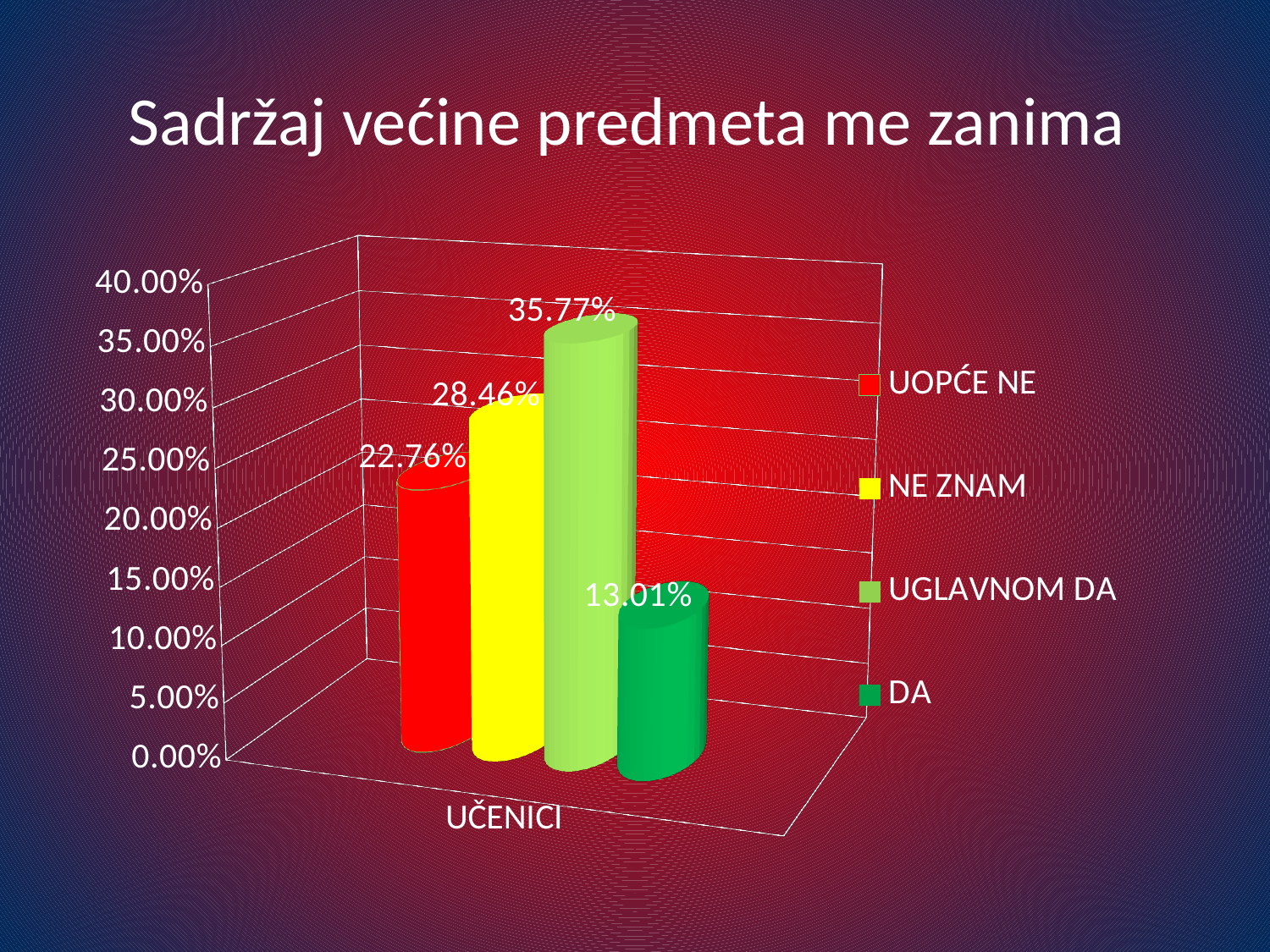
How many series does the legend list? 4 What is the value for UGLAVNOM DA? 35.77% Which series has the highest value? UGLAVNOM DA What is the title of the chart? Sadržaj većine predmeta me zanima What kind of chart is shown on the slide? Bar chart What is the value for DA? 13.01% What is the value for NE ZNAM? 28.46% What is the difference between the values for NE ZNAM and UOPĆE NE? 5.70% Which is larger, the value for NE ZNAM or the value for UOPĆE NE? NE ZNAM Which series has the lowest value? DA What is the value for UOPĆE NE? 22.76% What is the difference between the values for UGLAVNOM DA and DA? 22.76%